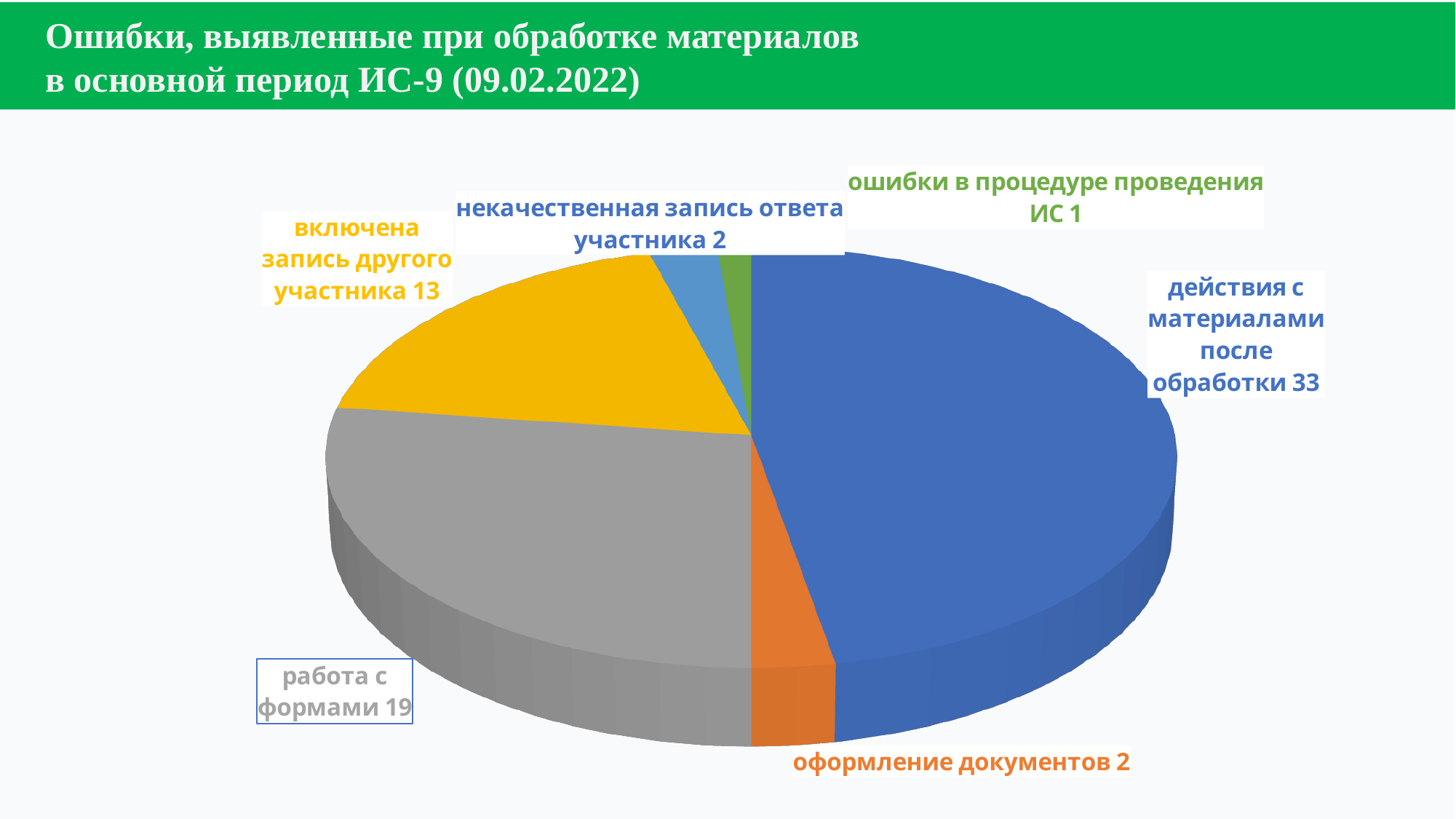
What is the total of all values shown in the pie chart? 70 How many slices does the pie chart have? 6 Which category has the largest slice of the pie? действия с материалами после обработки What is the difference between the values for "действия с материалами после обработки" and "работа с формами"? 14 What type of chart is shown on the slide? Pie chart What colour is the slice for "оформление документов"? Orange What is the value for "включена запись другого участника"? 13 What is the value for "ошибки в процедуре проведения ИС"? 1 What is the value for "действия с материалами после обработки"? 33 Which category has the smallest slice of the pie? ошибки в процедуре проведения ИС What is the value for "работа с формами"? 19 Which is larger: "работа с формами" or "включена запись другого участника"? работа с формами